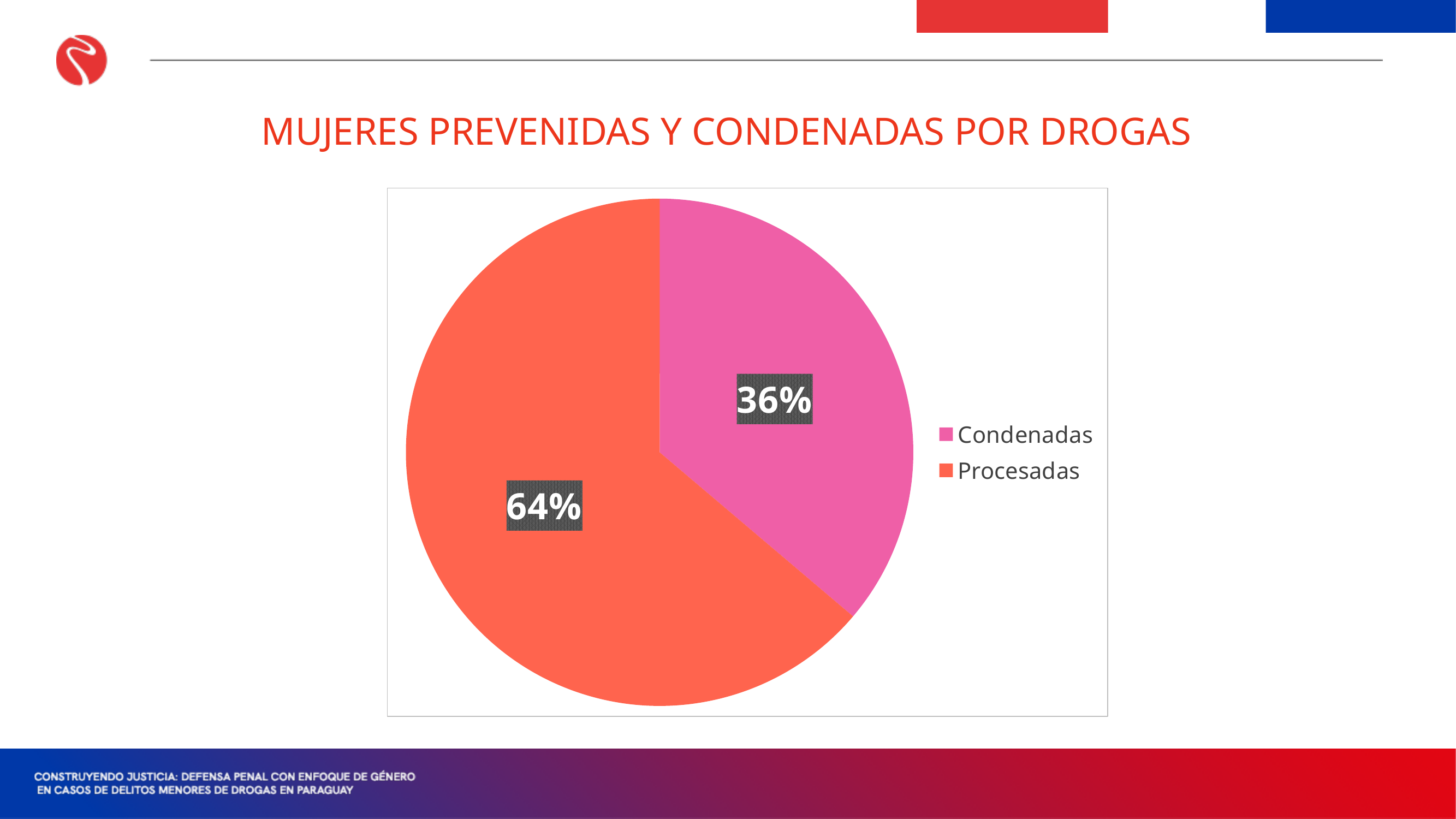
Which slice of the pie is the smallest? Condenadas What share of the pie does Procesadas represent? 64% Which is larger, Condenadas or Procesadas? Procesadas How many slices does the pie chart have? 2 What is the difference in percentage points between Procesadas and Condenadas? 28 What is the title of the slide above the chart? MUJERES PREVENIDAS Y CONDENADAS POR DROGAS Which slice of the pie is the largest? Procesadas What percentage of the pie is Condenadas? 36% What kind of chart is shown on the slide? Pie chart How many entries does the legend list? 2 What percentage of the pie is Procesadas? 64% Which legend entry is shown in pink? Condenadas